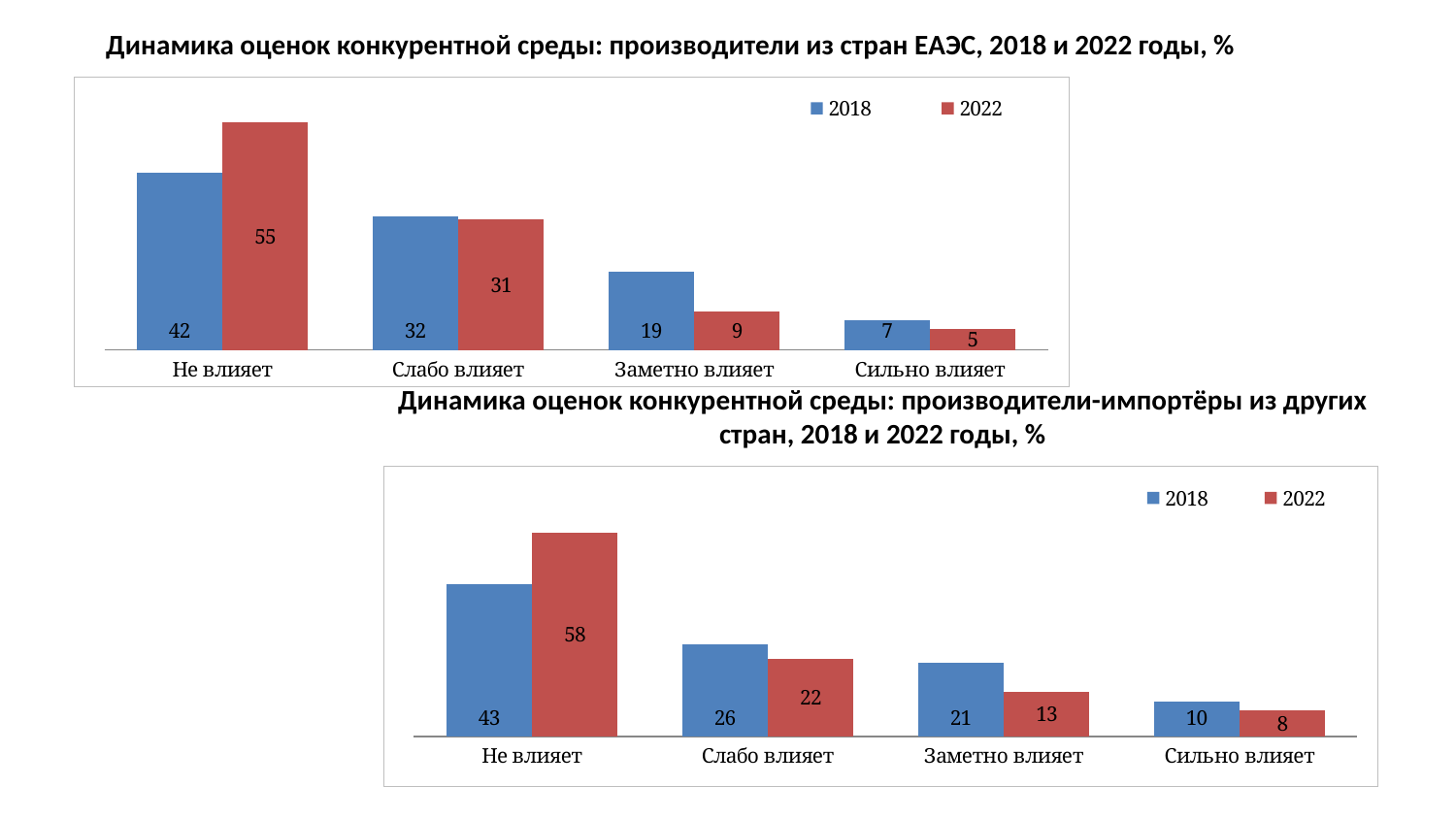
What type of chart is the top chart (producers from EAEU countries)? Bar chart In the bottom chart (producer-importers from other countries), do the 2018 values rise or fall from 'Не влияет' to 'Сильно влияет'? Fall In the bottom chart (producer-importers from other countries), what is the difference between the 2018 and 2022 values for 'Заметно влияет'? 8 How many series does the legend of the bottom chart (producer-importers from other countries) list? 2 In the top chart (producers from EAEU countries), which category has the lowest 2018 value? Сильно влияет In the bottom chart (producer-importers from other countries), what is the 2022 value for 'Слабо влияет'? 22 In the top chart (producers from EAEU countries), what is the 2022 value for 'Не влияет'? 55 In the bottom chart (producer-importers from other countries), which is larger for 'Сильно влияет': the 2018 value or the 2022 value? 2018 How many categories are shown on the x axis of the top chart (producers from EAEU countries)? 4 In the bottom chart (producer-importers from other countries), which category has the highest 2022 value? Не влияет In the top chart (producers from EAEU countries), what is the 2018 value for 'Заметно влияет'? 19 In the top chart (producers from EAEU countries), what is the difference between the 2022 and 2018 values for 'Не влияет'? 13